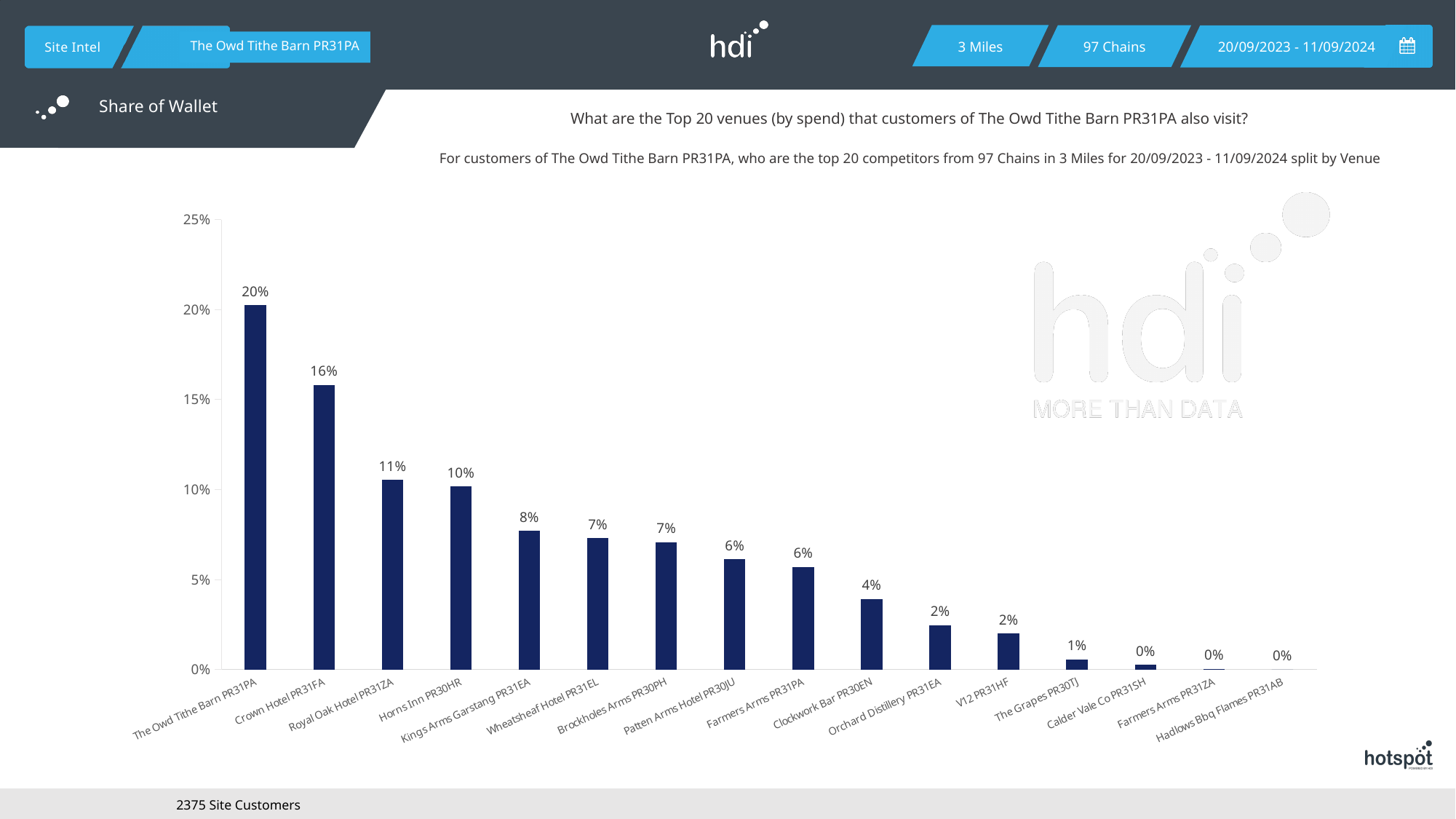
Which is larger, the value for Royal Oak Hotel PR31ZA or the value for Kings Arms Garstang PR31EA? Royal Oak Hotel PR31ZA Is the value for Crown Hotel PR31FA greater or less than 15%? greater What is the value for The Grapes PR30TJ? 1% What is the difference between the values for The Owd Tithe Barn PR31PA and Crown Hotel PR31FA? 4% What is the value for Horns Inn PR30HR? 10% Which venue has the highest share of wallet? The Owd Tithe Barn PR31PA Do the values rise or fall from left to right along the x axis? Fall What percentage is shown for Crown Hotel PR31FA? 16% What kind of chart is shown on the slide? Bar chart How many venues are shown on the chart? 16 What is the highest value shown on the y axis? 25% What is the value for Clockwork Bar PR30EN? 4%